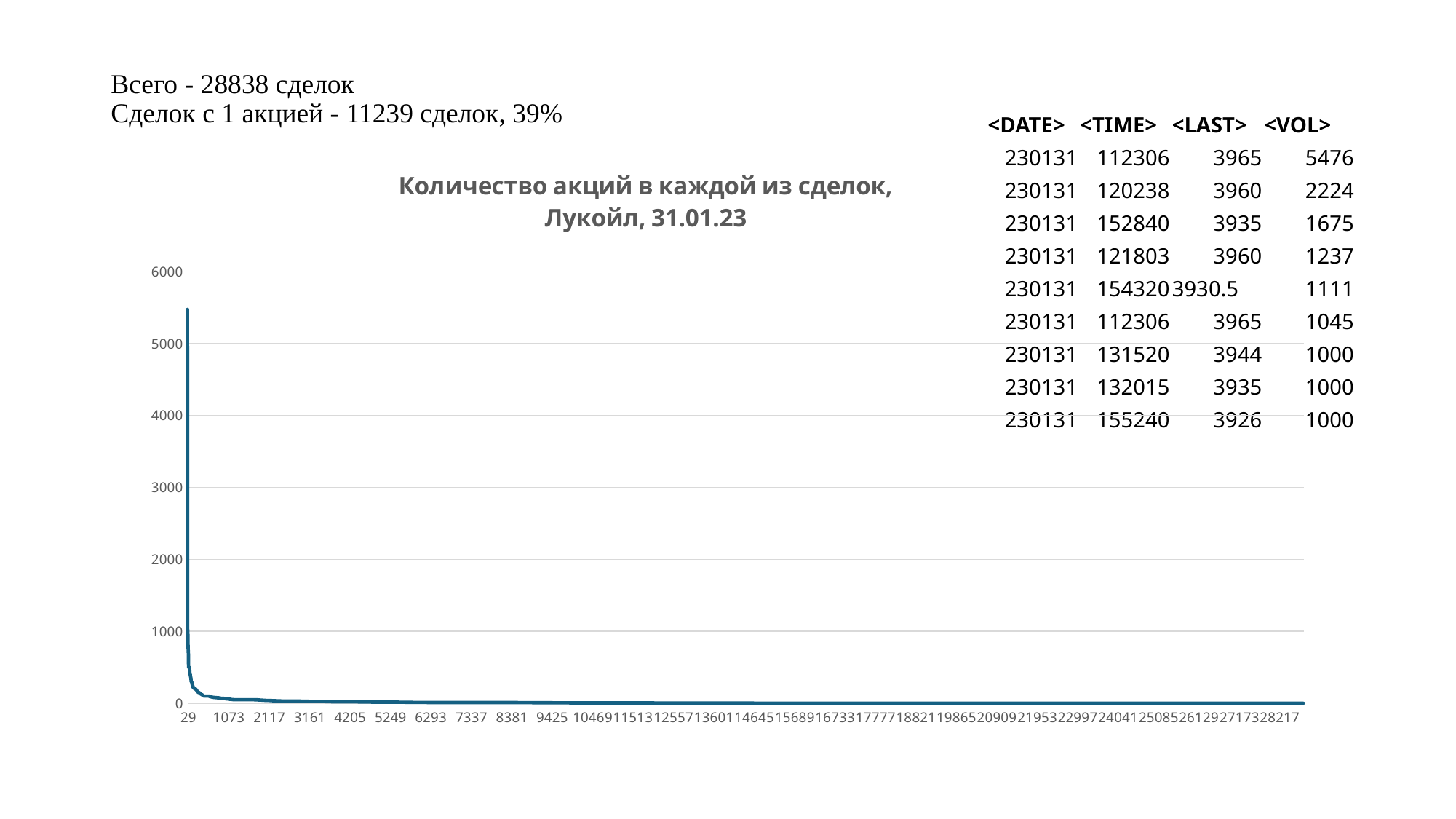
Is the value of the line at x = 1073 greater or less than 1000? less Is the value at the last point of the line (x = 28217) greater or less than 1000? less Do the values rise or fall along the x axis of the chart? fall What is the highest tick value shown on the y axis of the chart? 6000 What is the title of the chart? Количество акций в каждой из сделок, Лукойл, 31.01.23 Is the value of the line at x = 14645 greater or less than 1000? less What is the last label shown on the x axis of the chart? 28217 What is the first label shown on the x axis of the chart? 29 What kind of chart is shown on the slide? line chart